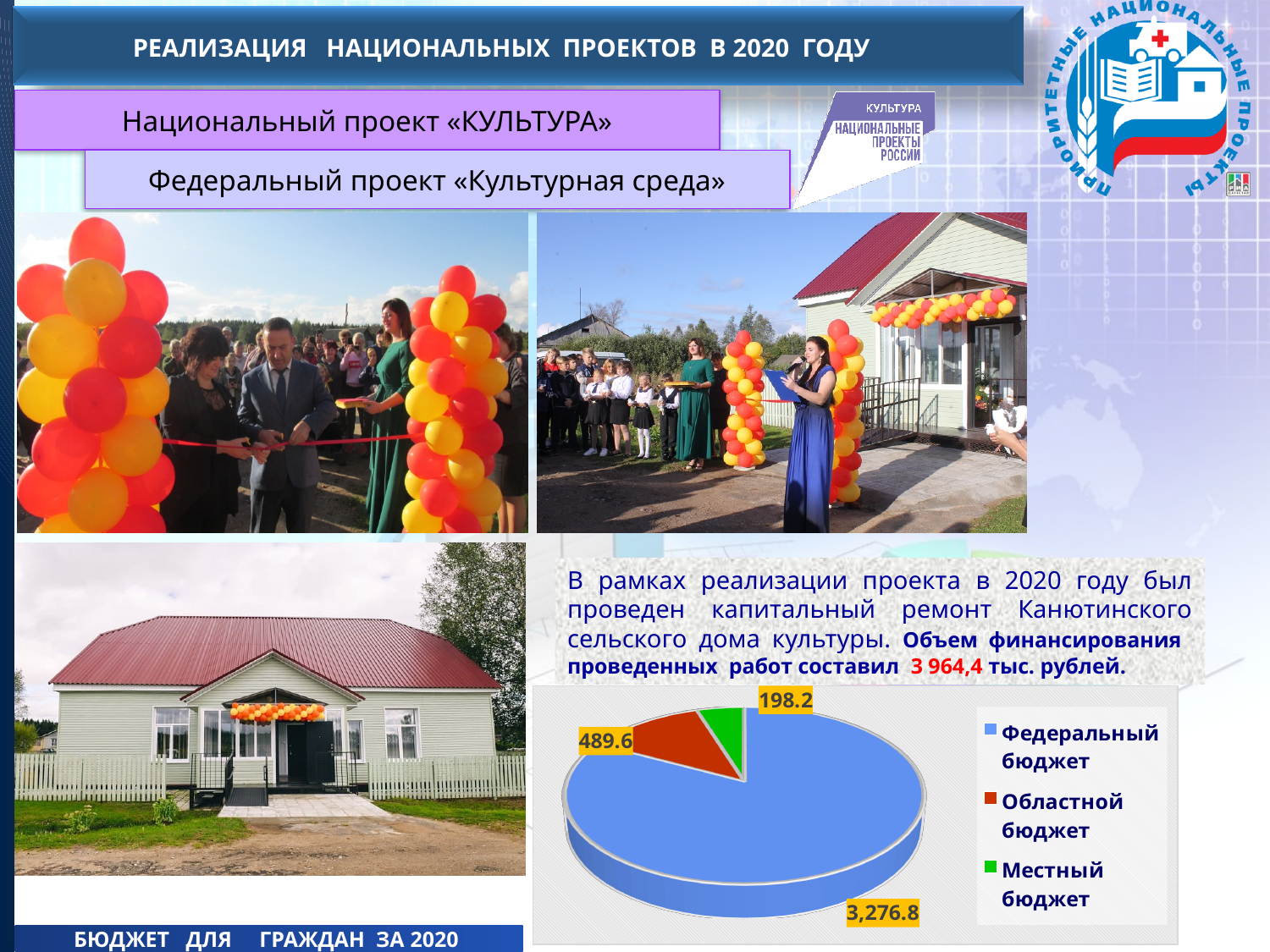
How many entries does the legend of the pie chart list? 3 Which budget source has the largest slice in the pie chart? Федеральный бюджет Which budget source has the smallest slice in the pie chart? Местный бюджет What colour is the slice for Местный бюджет in the pie chart? green What is the value for Федеральный бюджет in the pie chart? 3,276.8 Which is larger in the pie chart: Областной бюджет or Местный бюджет? Областной бюджет How many slices does the pie chart have? 3 What is the difference between the values for Федеральный бюджет and Областной бюджет? 2,787.2 What is the value for Областной бюджет in the pie chart? 489.6 What is the value for Местный бюджет in the pie chart? 198.2 What kind of chart is shown on the slide? pie chart What is the difference between the values for Областной бюджет and Местный бюджет? 291.4